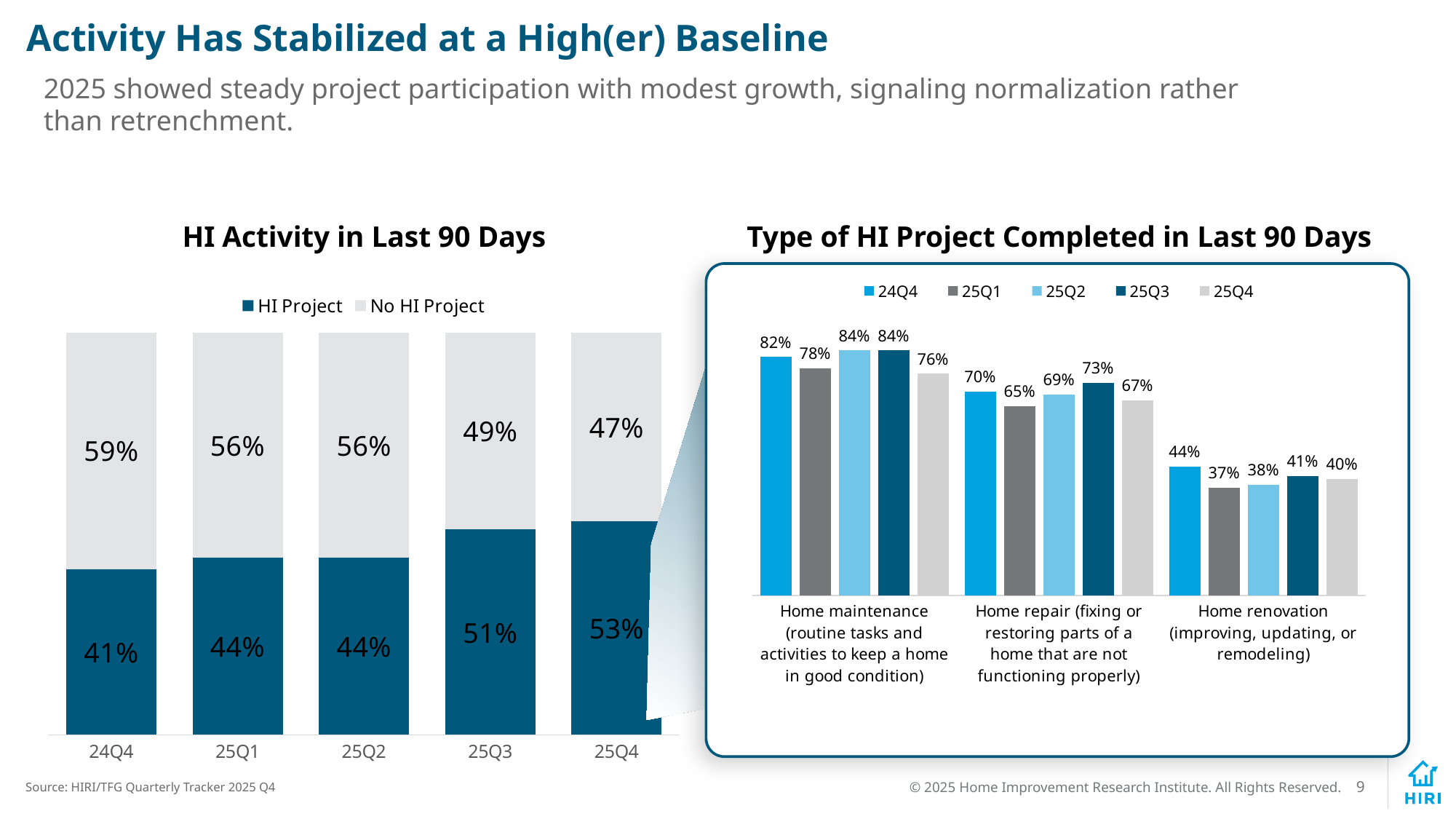
In the 'HI Activity in Last 90 Days' chart, what is the HI Project value for 25Q4? 53% In the 'Type of HI Project Completed in Last 90 Days' chart, which is larger for Home renovation: 24Q4 or 25Q4? 24Q4 In the 'Type of HI Project Completed in Last 90 Days' chart, which quarter has the lowest value for Home maintenance? 25Q4 In the 'HI Activity in Last 90 Days' chart, which quarter has the lowest HI Project value? 24Q4 In the 'Type of HI Project Completed in Last 90 Days' chart, how many series does the legend list? 5 In the 'HI Activity in Last 90 Days' chart, what is the No HI Project value for 24Q4? 59% In the 'HI Activity in Last 90 Days' chart, how many quarters are shown on the x axis? 5 What kind of chart is 'HI Activity in Last 90 Days'? stacked bar chart In the 'Type of HI Project Completed in Last 90 Days' chart, what is the 25Q3 value for Home repair? 73% In the 'Type of HI Project Completed in Last 90 Days' chart, what is the 25Q1 value for Home renovation? 37% In the 'HI Activity in Last 90 Days' chart, what is the difference between the HI Project values for 25Q4 and 24Q4? 12 percentage points In the 'HI Activity in Last 90 Days' chart, does the HI Project share rise or fall from 24Q4 to 25Q4? rise